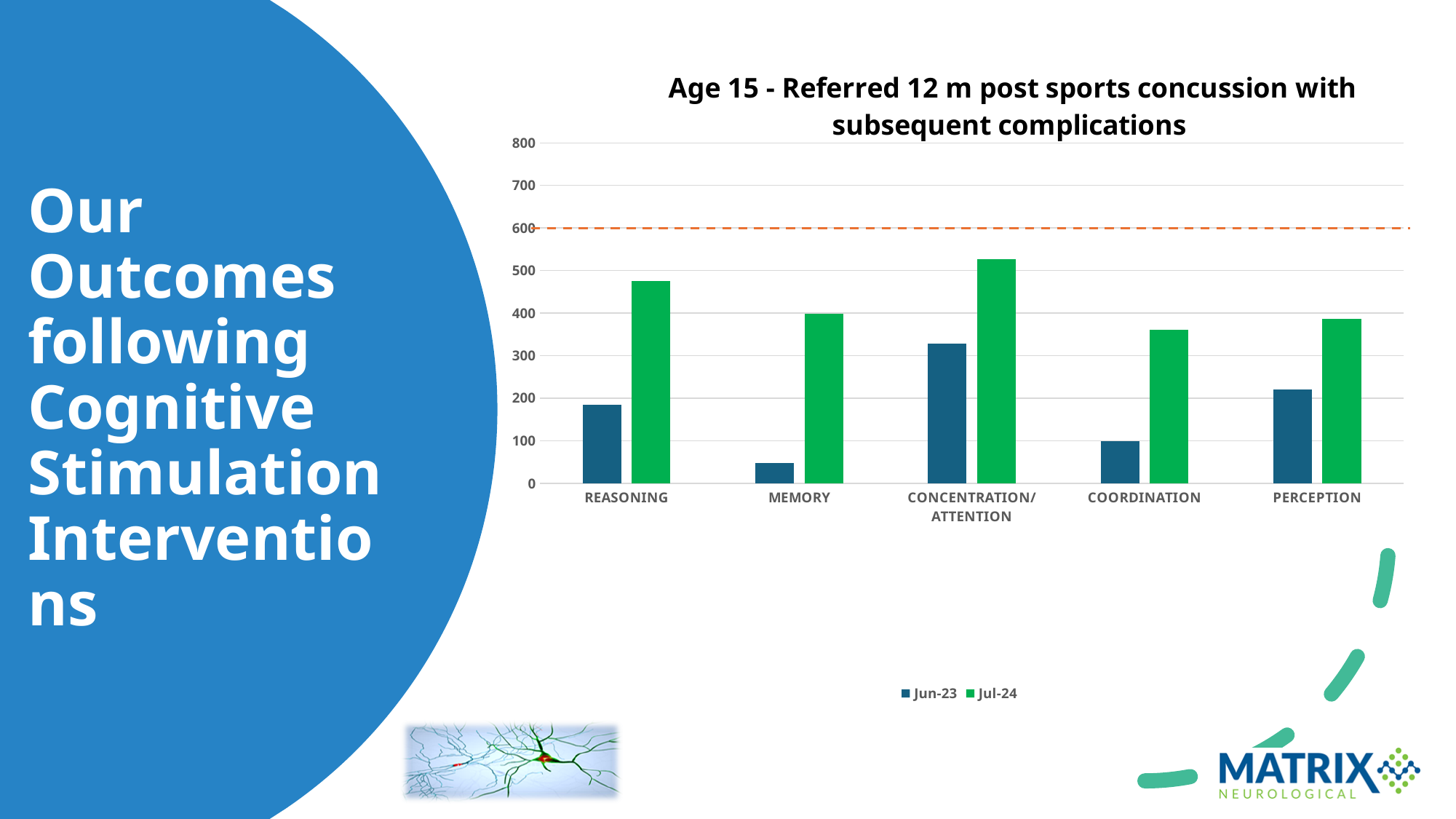
Is the Jul-24 value for Concentration/Attention greater or less than 500? greater How many series does the chart's legend list? 2 At what value on the y axis is the orange dashed horizontal line drawn? 600 Which category has the lowest Jun-23 value? Memory Is the Jun-23 value for Coordination greater or less than 200? less What kind of chart is shown on the slide? bar chart Is the Jul-24 value for Reasoning greater or less than 400? greater How many categories are shown on the x axis of the chart? 5 What is the title of the chart? Age 15 - Referred 12 m post sports concussion with subsequent complications Which category has the highest Jun-23 value? Concentration/Attention Which category has the highest Jul-24 value? Concentration/Attention Which is larger for Perception, the Jun-23 value or the Jul-24 value? Jul-24